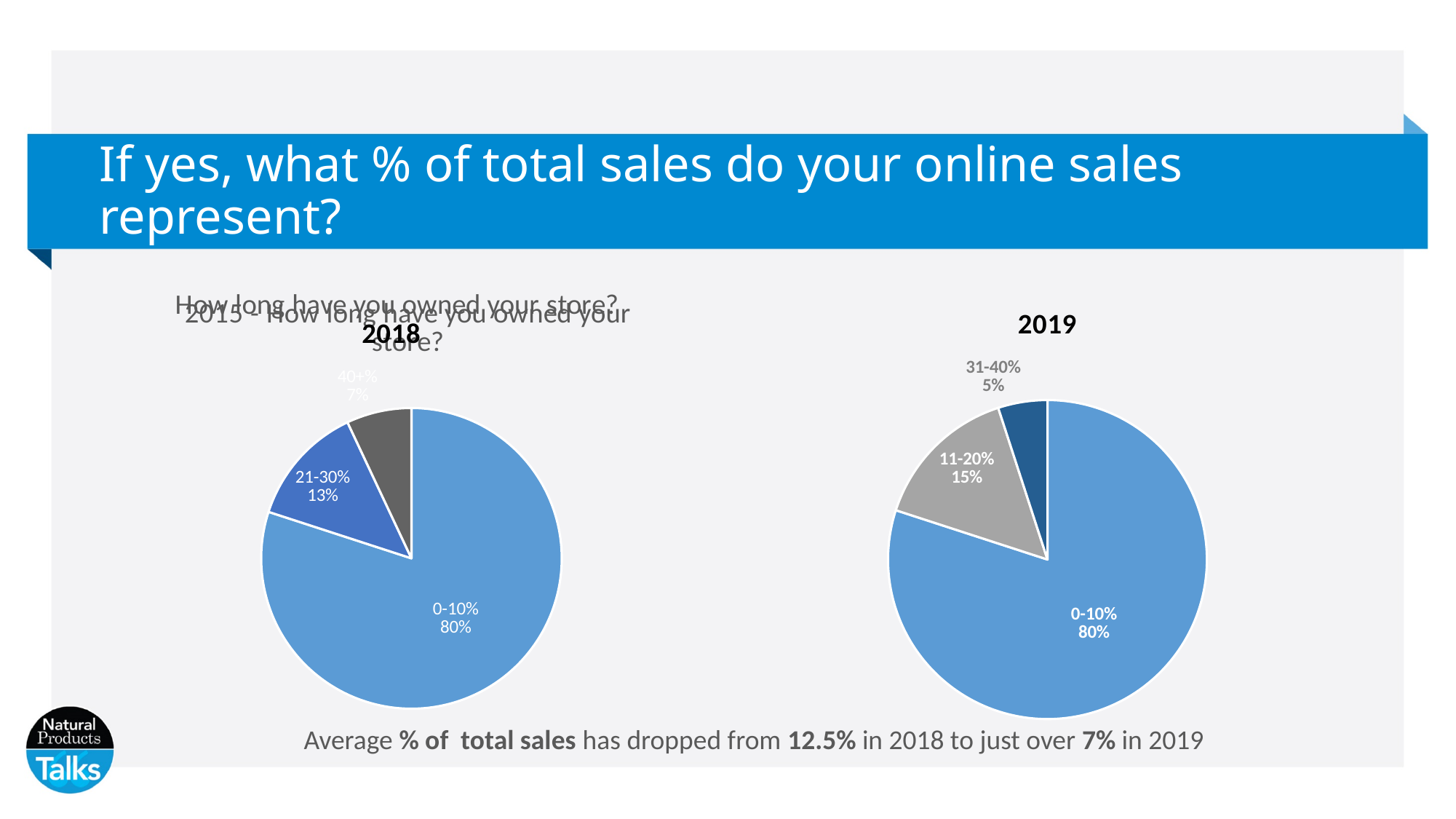
In the 2018 pie chart, what share is shown for the 21-30% category? 13% In the 2019 pie chart, which category has the largest slice? 0-10% In the 2018 pie chart, what share is shown for the 40+% category? 7% What type of chart is used for the 2018 data? pie chart In the 2018 pie chart, what share of respondents is in the 0-10% category? 80% How many slices does the 2019 pie chart have? 3 What is the title of the pie chart on the right side of the slide? 2019 In the 2018 pie chart, which category has the smallest slice? 40+% Which is larger in the 2019 pie chart: the 11-20% slice or the 31-40% slice? 11-20% In the 2018 pie chart, what is the difference between the 21-30% slice and the 40+% slice? 6%